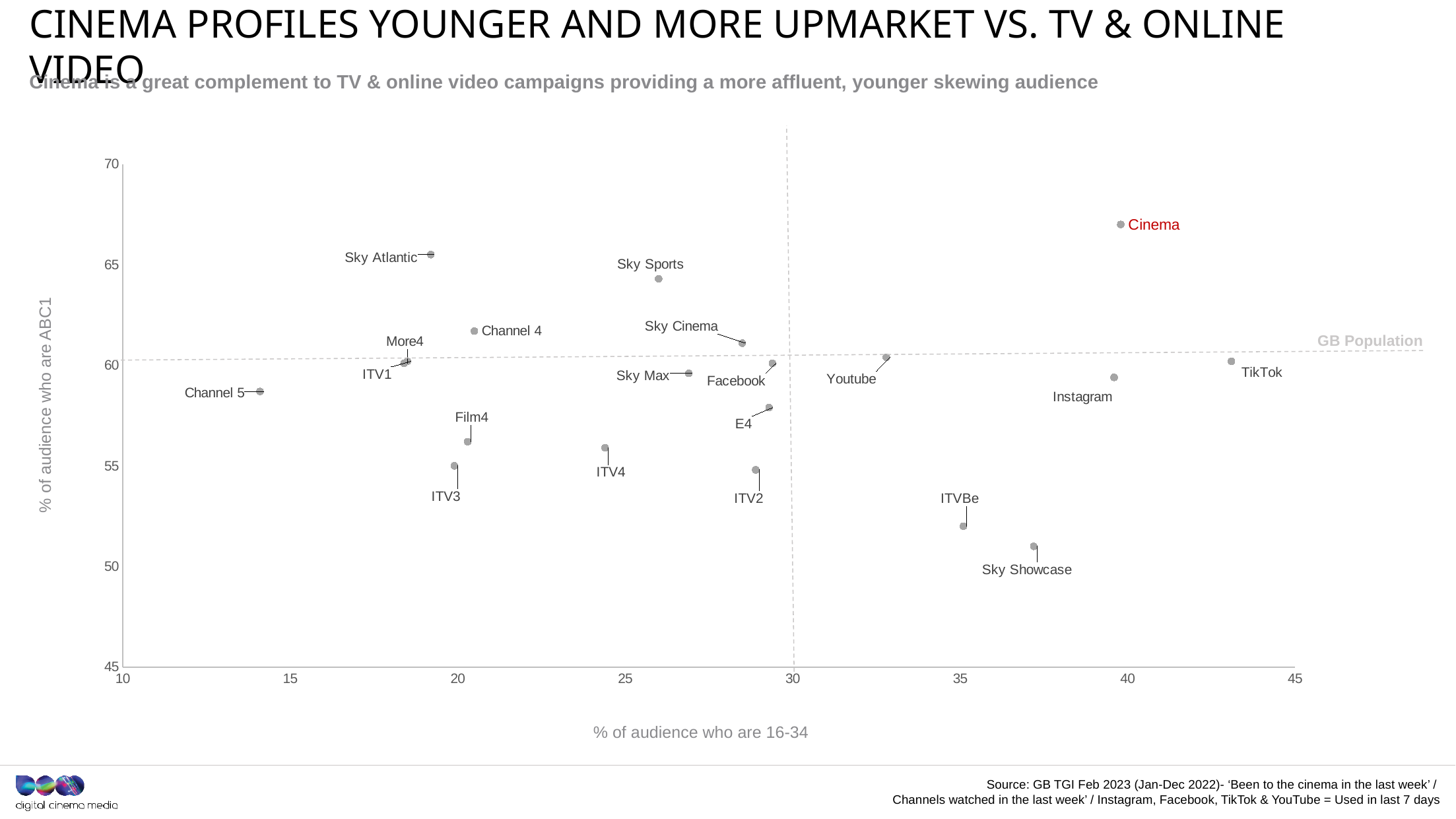
Which point has the highest % of audience who are ABC1? Cinema Is the % of audience who are 16-34 for TikTok greater or less than 40? greater What is the label on the horizontal dashed reference line? GB Population How many labelled points are plotted on the chart? 20 What kind of chart is shown on the slide? Scatter chart Which point has the highest % of audience who are 16-34? TikTok Which has a higher % of audience who are ABC1, Sky Sports or Cinema? Cinema Which point has the lowest % of audience who are 16-34? Channel 5 Is the % of audience who are 16-34 for Youtube greater or less than 30? greater Is the % of audience who are ABC1 for Cinema greater or less than 65? greater Which point has the lowest % of audience who are ABC1? Sky Showcase